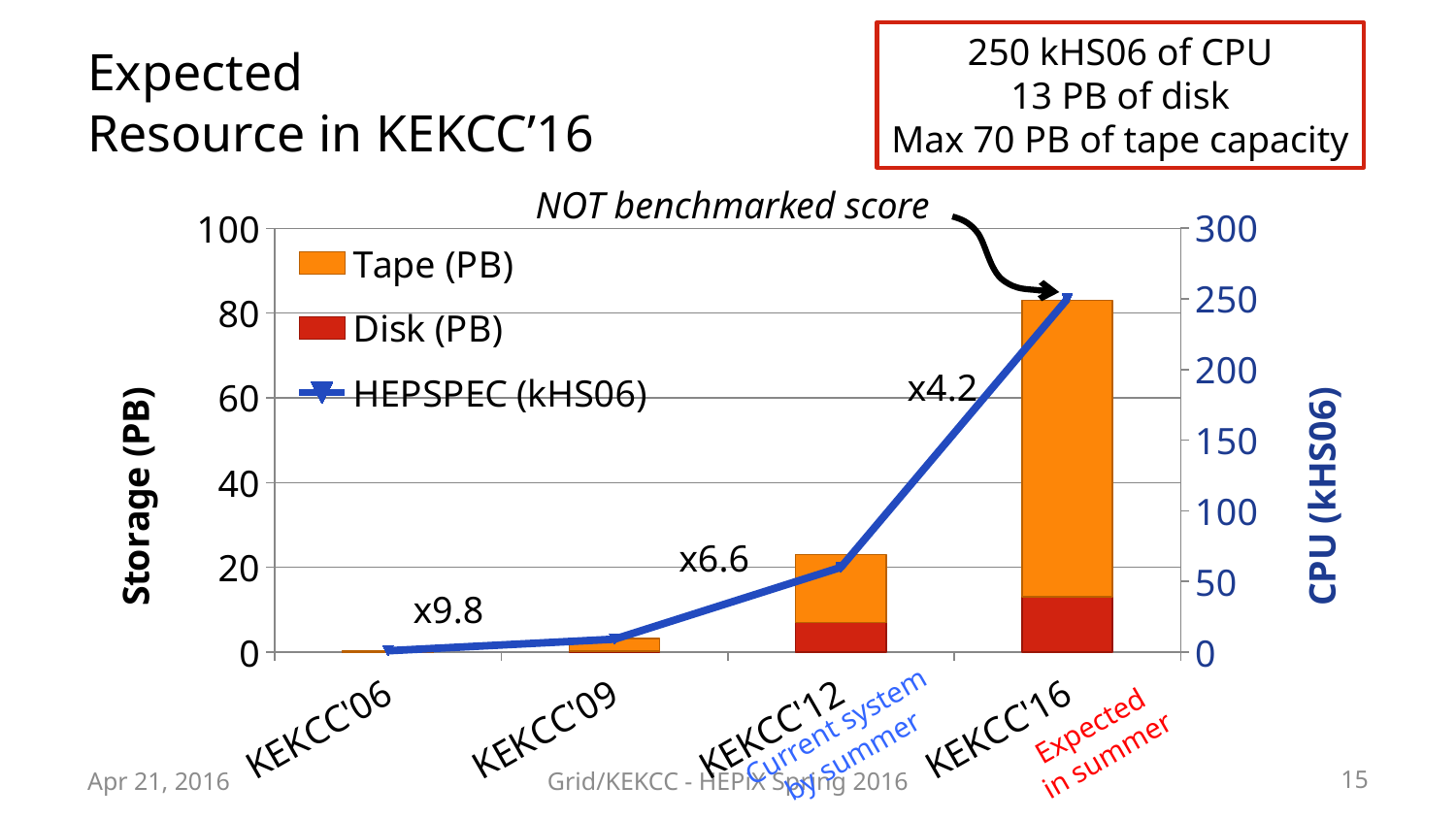
Which is larger, the HEPSPEC (kHS06) value for KEKCC'12 or for KEKCC'09? KEKCC'12 Is the HEPSPEC (kHS06) value for KEKCC'09 greater or less than 50? less How many categories are shown on the x axis of the chart? 4 Is the total stacked bar for KEKCC'12 greater or less than 20 on the Storage (PB) axis? greater Which category has the tallest stacked bar? KEKCC'16 How many series does the chart legend list? 3 What kind of chart is shown on the slide? Combination of stacked bar chart and line chart Which category has the lowest HEPSPEC (kHS06) value? KEKCC'06 What is the title of the right-hand vertical axis? CPU (kHS06) Do the HEPSPEC (kHS06) values rise or fall from KEKCC'06 to KEKCC'16? Rise What is the HEPSPEC (kHS06) value for KEKCC'16? 250 kHS06 What is the Disk (PB) value for KEKCC'16? 13 PB